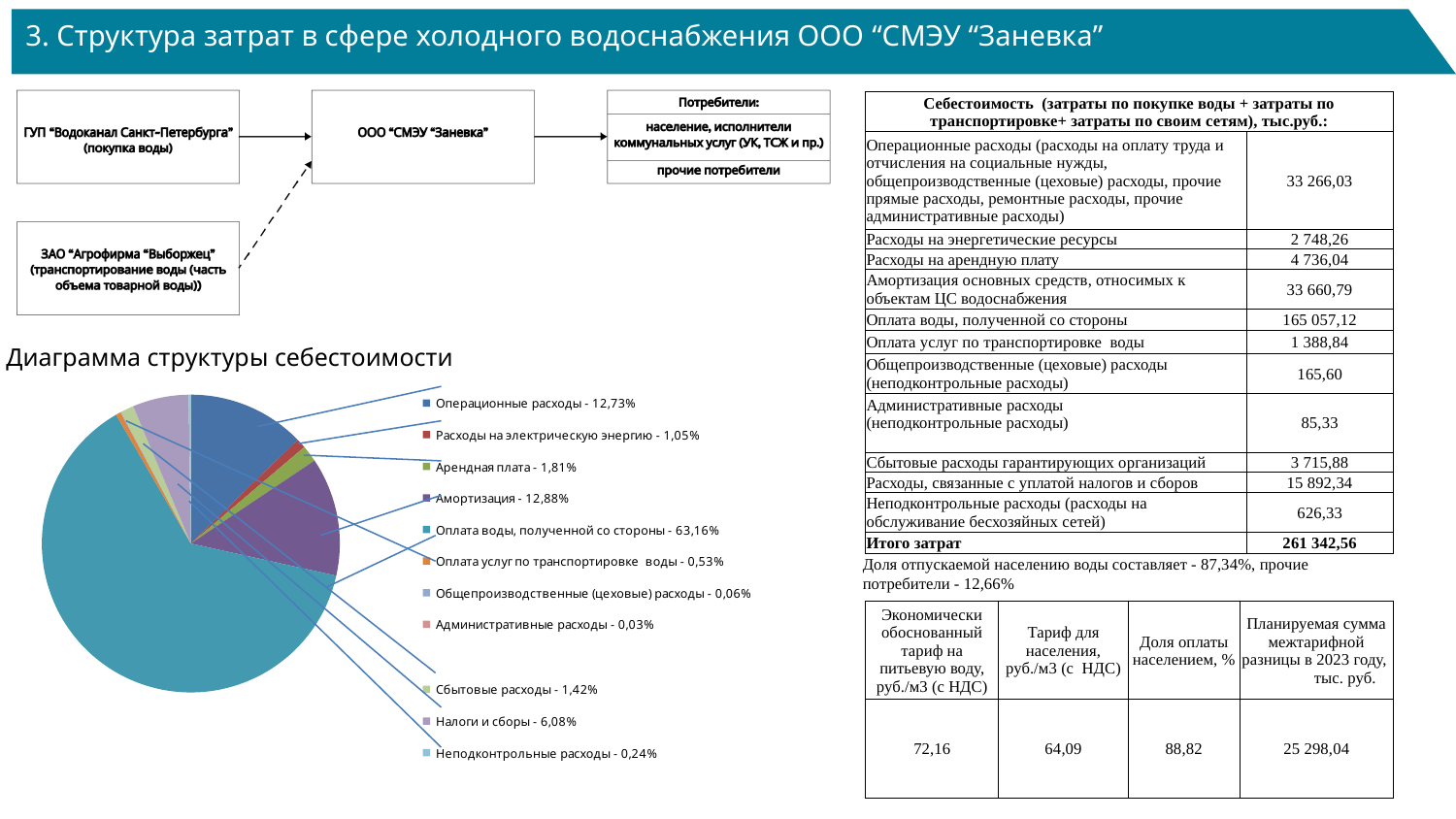
In the pie chart, what share is shown for "Налоги и сборы"? 6,08% In the pie chart, what share is shown for "Амортизация"? 12,88% Which category has the largest slice in the pie chart? Оплата воды, полученной со стороны In the pie chart, what is the difference between the shares of "Налоги и сборы" and "Сбытовые расходы"? 4,66% How many categories (slices) does the pie chart "Диаграмма структуры себестоимости" have? 11 What kind of chart is shown under the heading "Диаграмма структуры себестоимости"? pie chart In the pie chart, what is the difference between the shares of "Амортизация" and "Операционные расходы"? 0,15% In the pie chart, which is larger: "Арендная плата" or "Сбытовые расходы"? Арендная плата In the pie chart, what share is shown for "Операционные расходы"? 12,73% In the pie chart, what share is shown for "Оплата воды, полученной со стороны"? 63,16% Which category has the smallest share in the pie chart? Административные расходы What is the title shown above the pie chart? Диаграмма структуры себестоимости